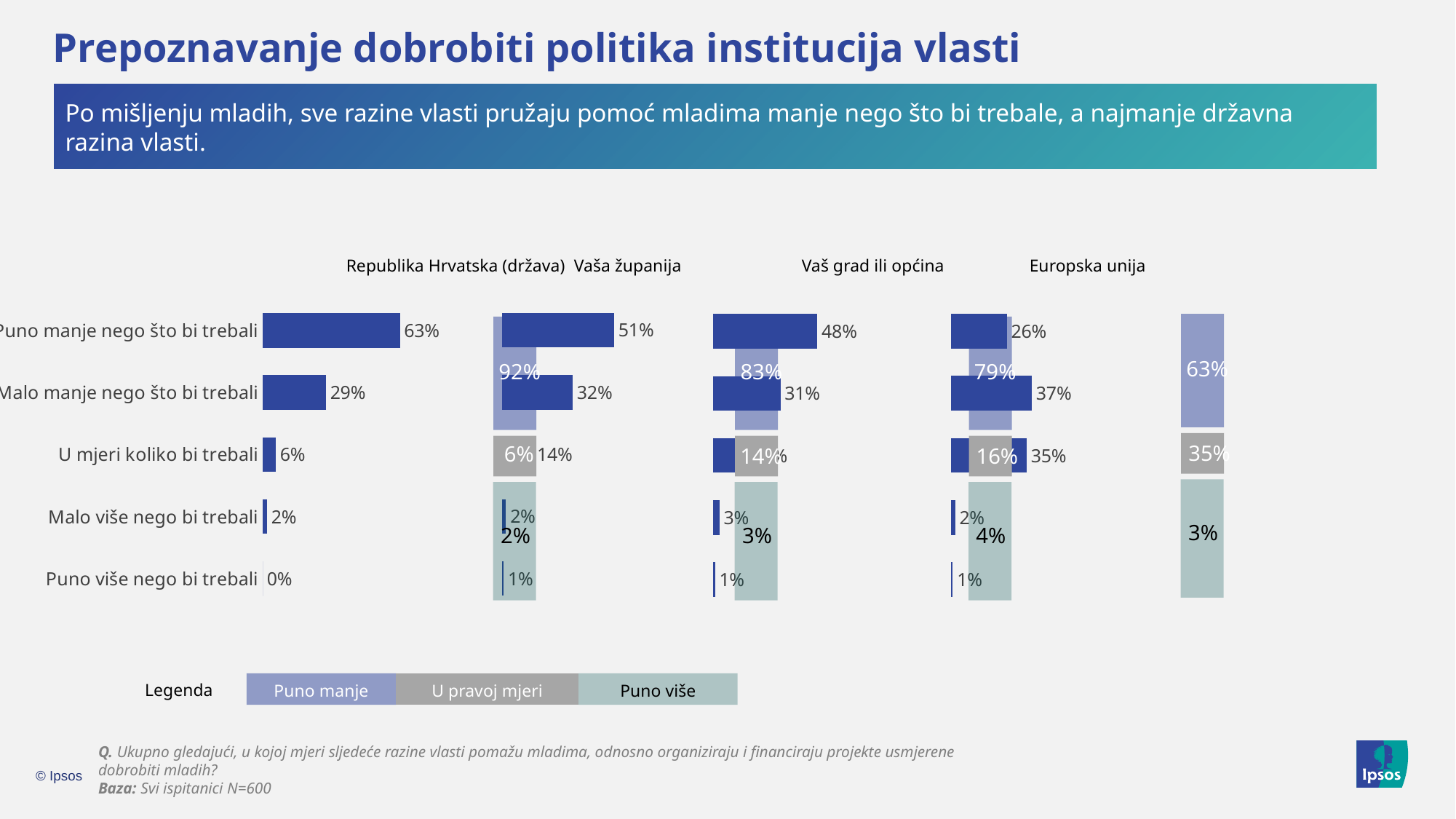
In the Europska unija chart, what is the value for "U mjeri koliko bi trebali"? 35% In the Vaš grad ili općina chart, what is the difference between "Puno manje nego što bi trebali" and "Malo manje nego što bi trebali"? 17% In the Republika Hrvatska (država) chart, what is the value for "Puno manje nego što bi trebali"? 63% How many entries does the legend at the bottom of the slide list? 3 In the Republika Hrvatska (država) chart, which category has the lowest value? Puno više nego bi trebali What is the combined "Puno manje" share shown in the summary bar for Vaša županija? 83% In the Vaša županija chart, what is the value for "Malo manje nego što bi trebali"? 32% How many categories are shown in each of the bar charts? 5 Which is larger: "Puno manje nego što bi trebali" for Republika Hrvatska (država) or for Vaša županija? Republika Hrvatska (država) In the Europska unija chart, which category has the highest value? Malo manje nego što bi trebali What type of chart is used to show the responses for each level of government? Bar chart In the Vaš grad ili općina chart, what is the value for "Malo više nego bi trebali"? 3%